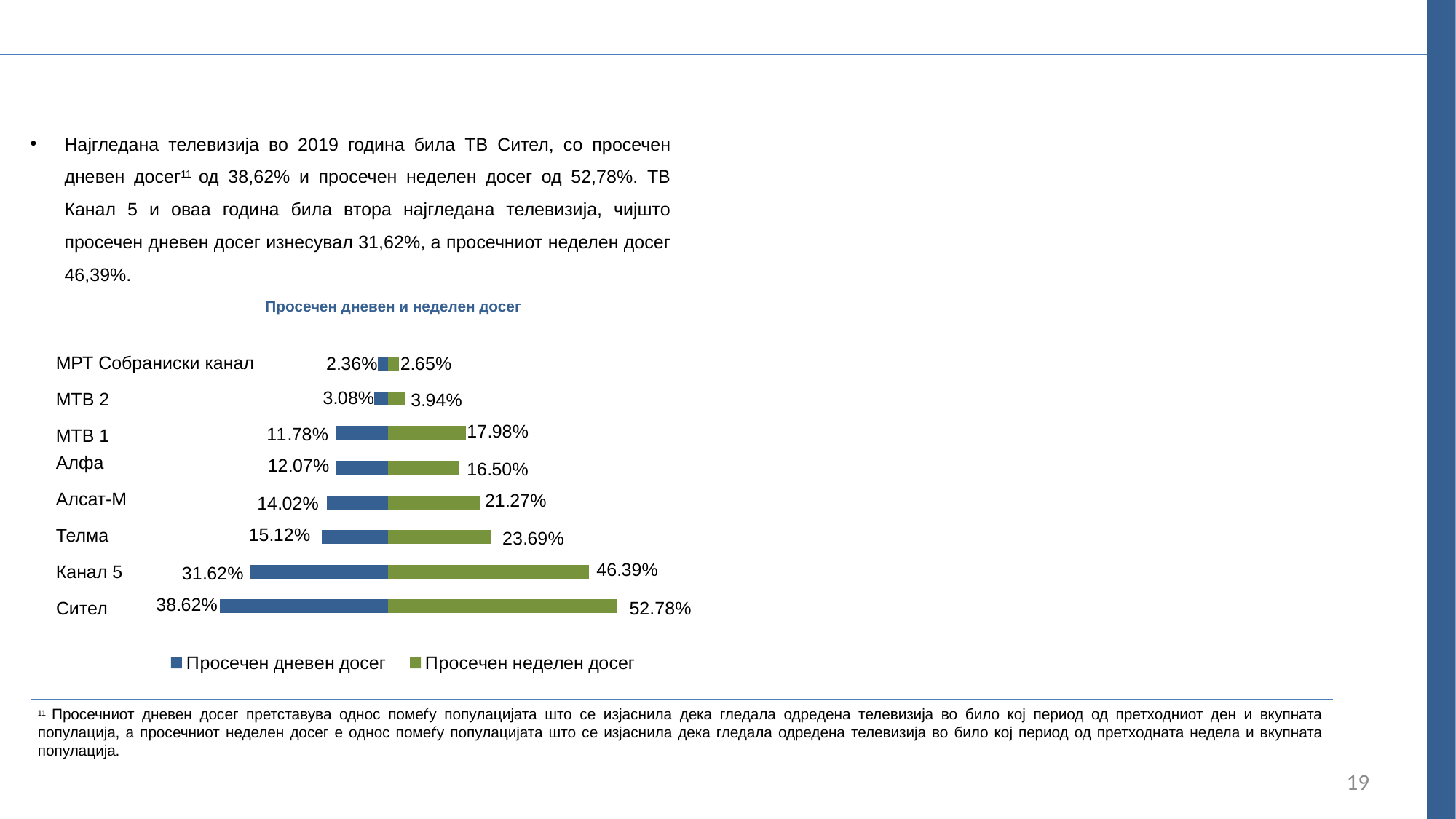
What is the average weekly reach (Просечен неделен досег) for Канал 5? 46.39% What is the title of the chart? Просечен дневен и неделен досег How many channels are shown in the chart? 8 Which channel has the highest average weekly reach (Просечен неделен досег)? Сител How many series does the legend list? 2 Which is larger: the average daily reach of Алсат-М or the average daily reach of Алфа? Алсат-М Which channel has the lowest average daily reach (Просечен дневен досег)? МРТ Собраниски канал What is the average daily reach (Просечен дневен досег) for МТВ 1? 11.78% What type of chart is shown on the slide? bar chart What is the average weekly reach (Просечен неделен досег) for Телма? 23.69% What is the difference between the average weekly reach and the average daily reach for Сител? 14.16% What is the average daily reach (Просечен дневен досег) for Сител? 38.62%